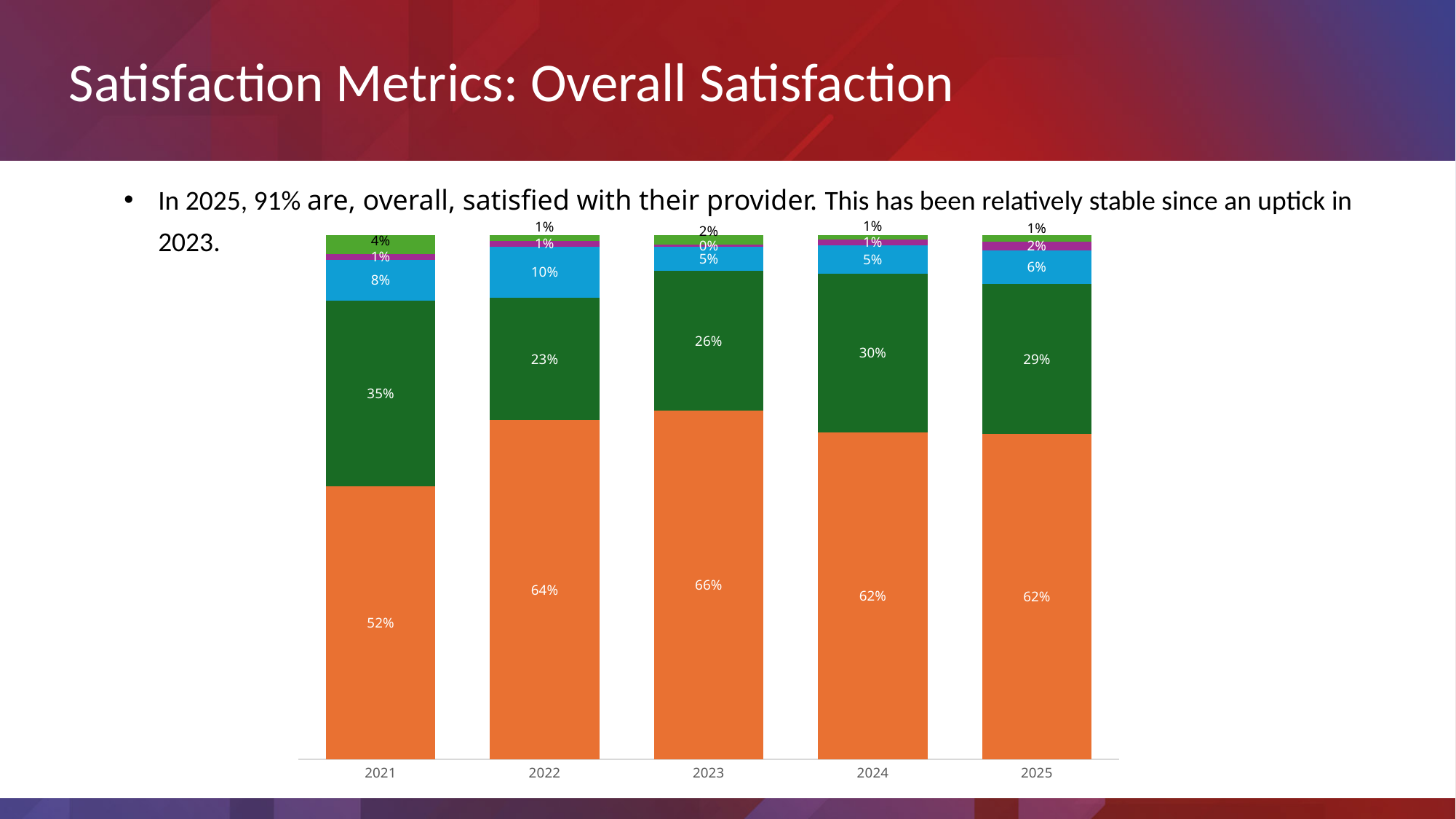
What is the combined value of the bottom (orange) and dark green segments for 2025? 91% What is the value of the bottom (orange) segment for 2021? 52% Does the bottom (orange) segment rise or fall from 2021 to 2023? Rise What is the value of the bottom (orange) segment for 2023? 66% What is the difference between the bottom (orange) segment values for 2023 and 2021? 14% Which year has the highest value for the bottom (orange) segment? 2023 Which year has the lowest value for the bottom (orange) segment? 2021 How many years are shown along the x axis of the chart? 5 What kind of chart is shown on the slide? Stacked bar chart What is the value of the blue segment for 2022? 10% What is the value of the dark green segment for 2024? 30% Which is larger, the dark green segment for 2021 or for 2022? 2021